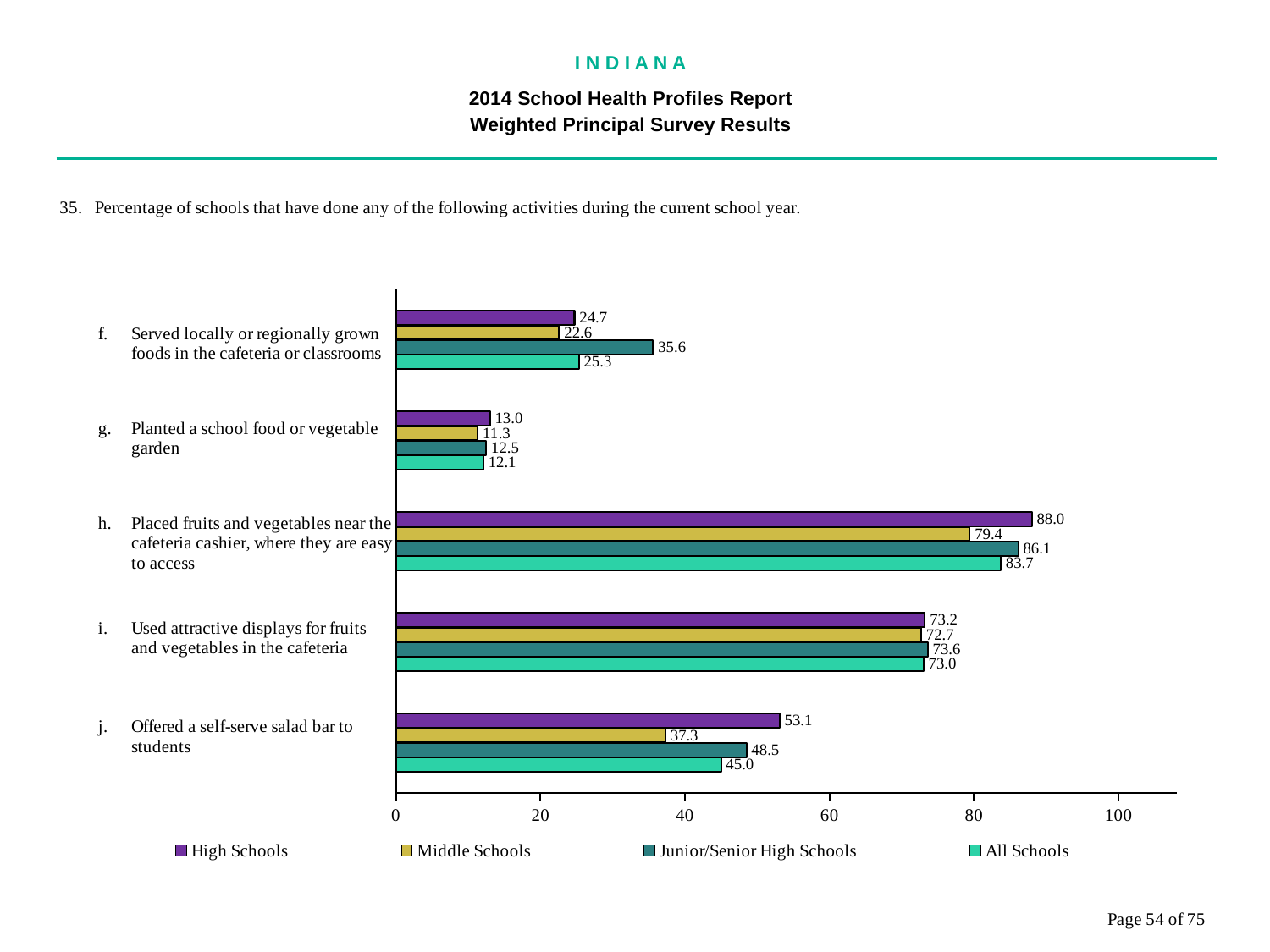
Which activity has the highest value for Middle Schools? Placed fruits and vegetables near the cafeteria cashier, where they are easy to access What is the value for Junior/Senior High Schools for 'Served locally or regionally grown foods in the cafeteria or classrooms'? 35.6 Is the All Schools value for 'Used attractive displays for fruits and vegetables in the cafeteria' greater or less than 60? greater What is the value for All Schools for 'Planted a school food or vegetable garden'? 12.1 What is the value for High Schools for 'Placed fruits and vegetables near the cafeteria cashier, where they are easy to access'? 88.0 Which activity has the lowest value for All Schools? Planted a school food or vegetable garden What is the value for Middle Schools for 'Offered a self-serve salad bar to students'? 37.3 What kind of chart is shown on the slide? Bar chart For 'Served locally or regionally grown foods in the cafeteria or classrooms', which is larger: the High Schools value or the Junior/Senior High Schools value? Junior/Senior High Schools How many activities (categories) are shown on the chart? 5 What is the difference between the High Schools and Middle Schools values for 'Offered a self-serve salad bar to students'? 15.8 How many series does the legend list? 4